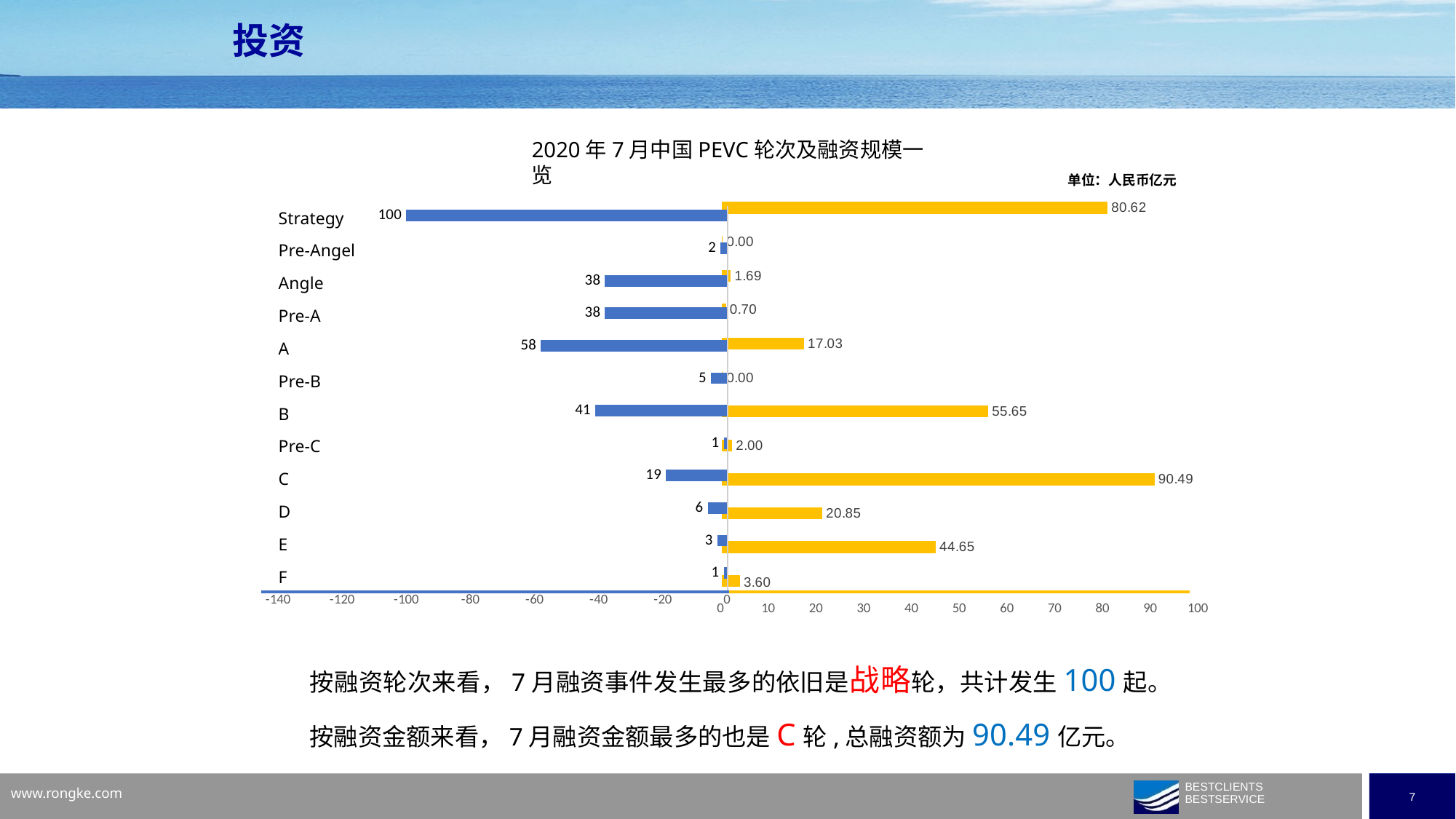
What unit is stated for the chart in the top-right corner? 人民币亿元 What is the difference between the yellow bar values for the C round and the Strategy round? 9.87 Which round has the highest yellow bar value (financing amount)? C How many financing round categories are listed on the chart? 12 What is the difference between the blue bar values for the A round and the B round? 17 What is the blue bar value for the A round? 58 What type of chart is shown on the slide? Bar chart Which has a larger yellow bar value, the D round or the E round? E What is the yellow bar value (financing amount) for the C round? 90.49 Which round has the highest blue bar value (number of events)? Strategy What is the blue bar value (number of events) for the Strategy round? 100 What is the yellow bar value for the B round? 55.65